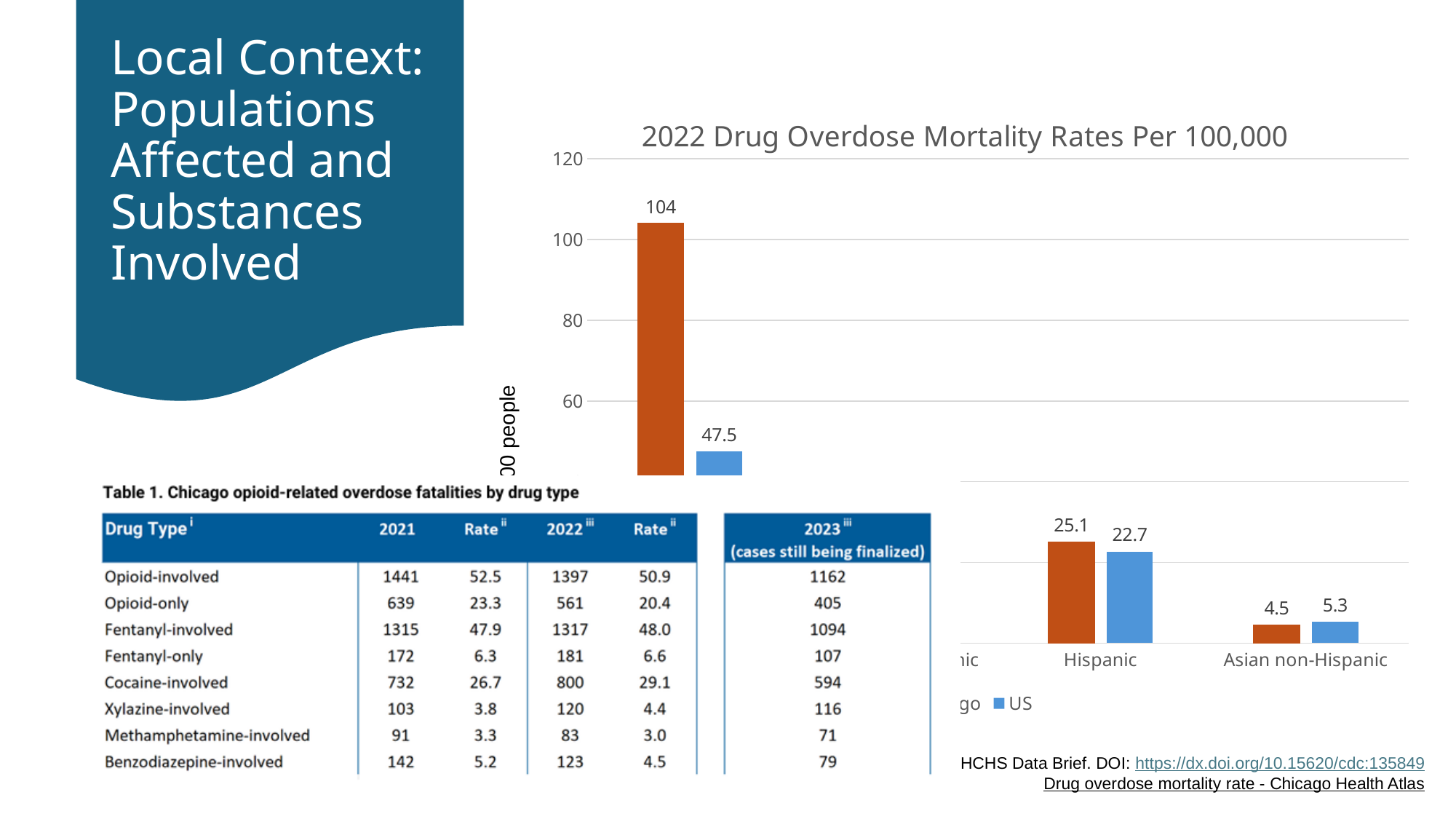
What is the highest value labeled on the chart? 104 What is the US value for Asian non-Hispanic in the chart? 5.3 What is the title of the chart? 2022 Drug Overdose Mortality Rates Per 100,000 What is the difference between the orange bar and the US bar for Hispanic? 2.4 What is the value of the orange bar for Asian non-Hispanic in the chart? 4.5 What is the US value for Hispanic in the chart? 22.7 What is the value of the orange bar for Hispanic in the chart? 25.1 Is the US value for Hispanic greater or less than 20? greater What kind of chart is shown on the slide? bar chart Which is larger: the US value for Hispanic or the US value for Asian non-Hispanic? Hispanic For Hispanic, which is larger: the orange bar or the US bar? the orange bar What is the difference between the US bar and the orange bar for Asian non-Hispanic? 0.8